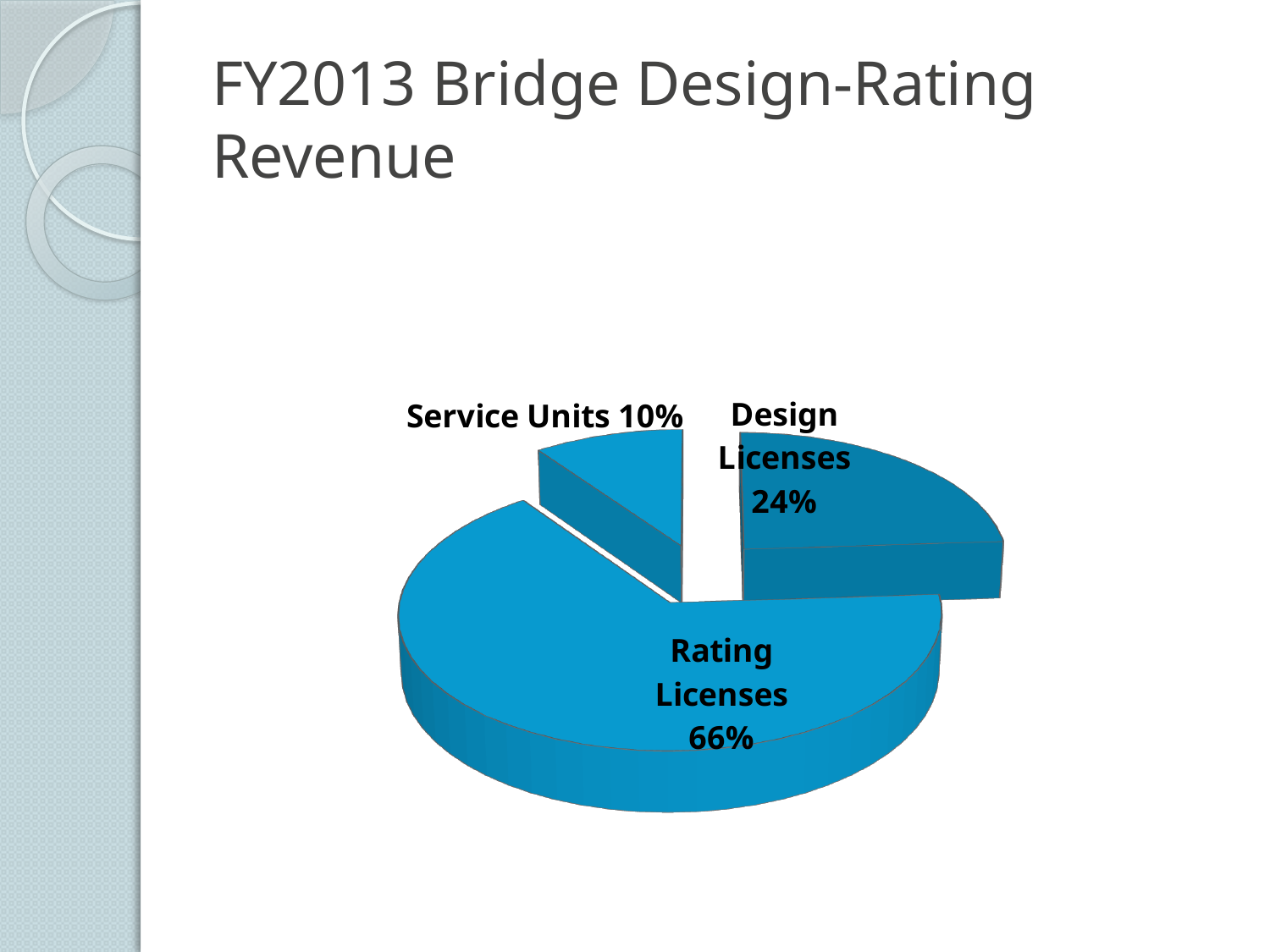
What is the difference in percentage points between Rating Licenses and Design Licenses? 42 What share of revenue comes from Rating Licenses? 66% Which category has the largest share of revenue? Rating Licenses What is the difference in percentage points between Design Licenses and Service Units? 14 What share of revenue comes from Design Licenses? 24% What is the combined share of Design Licenses and Service Units? 34% What type of chart is shown on the slide? pie chart Which is larger, the share for Design Licenses or the share for Service Units? Design Licenses How many categories are shown in the pie chart? 3 What is the title of the slide containing the pie chart? FY2013 Bridge Design-Rating Revenue What share of revenue comes from Service Units? 10% Which category has the smallest share of revenue? Service Units